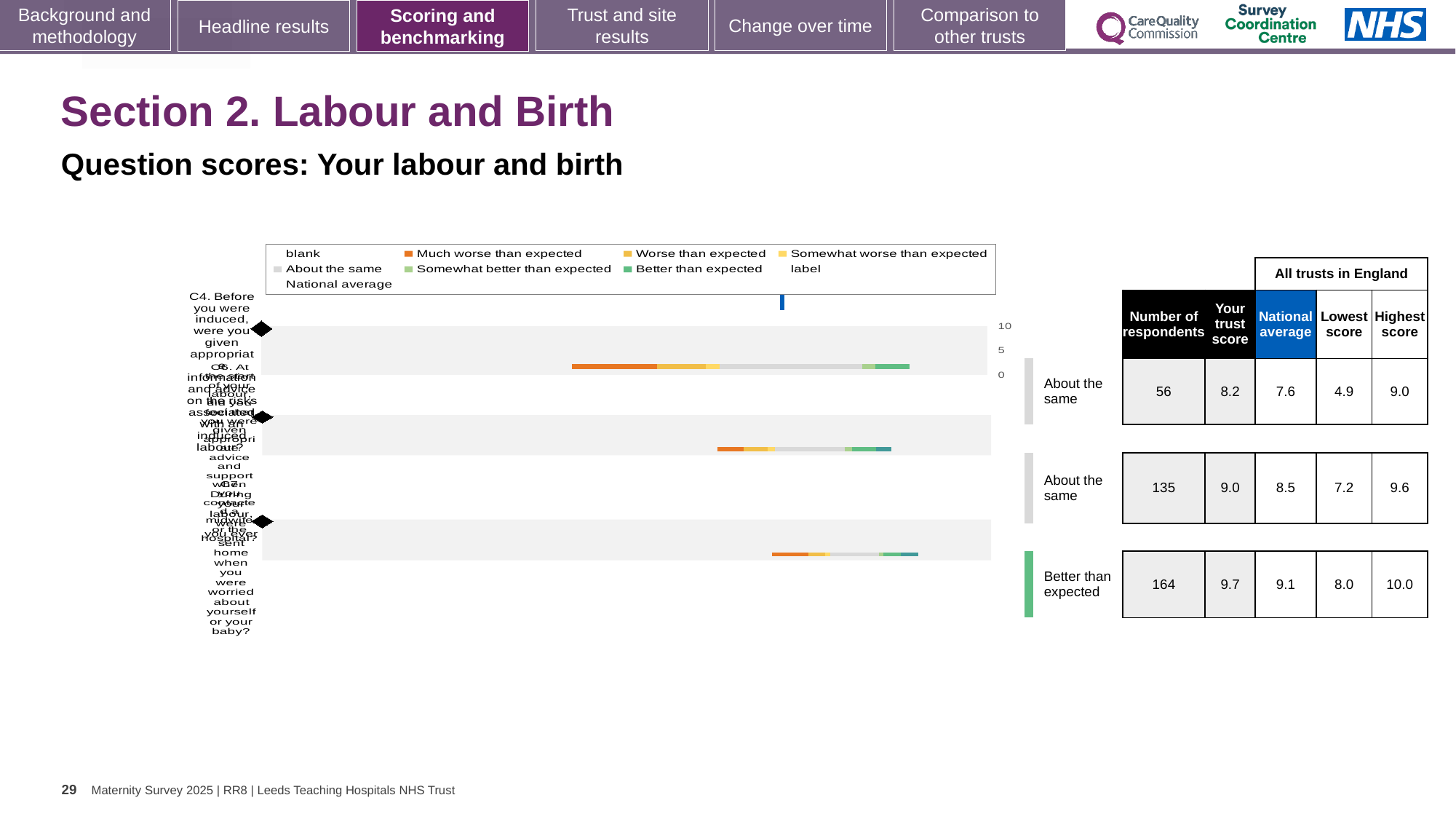
How many question bars are plotted in the chart? 3 In the table, what is the number of respondents for the first row? 56 In the table, what is the trust score for the row with 135 respondents? 9.0 Which row in the table has the lowest number of respondents? the row with 56 respondents Which row in the table has the highest trust score? the row with 164 respondents (9.7) What is the difference between the trust score and the national average for the row with 56 respondents? 0.6 In the table, what is the lowest score for the row with 164 respondents? 8.0 In the table, what is the highest score for the row with 56 respondents? 9.0 What benchmark label is shown next to the row with 164 respondents? Better than expected In the table, what is the national average for the row with 164 respondents? 9.1 What kind of chart is shown on the slide? bar chart Is the trust score for the row with 135 respondents larger or smaller than its national average? larger